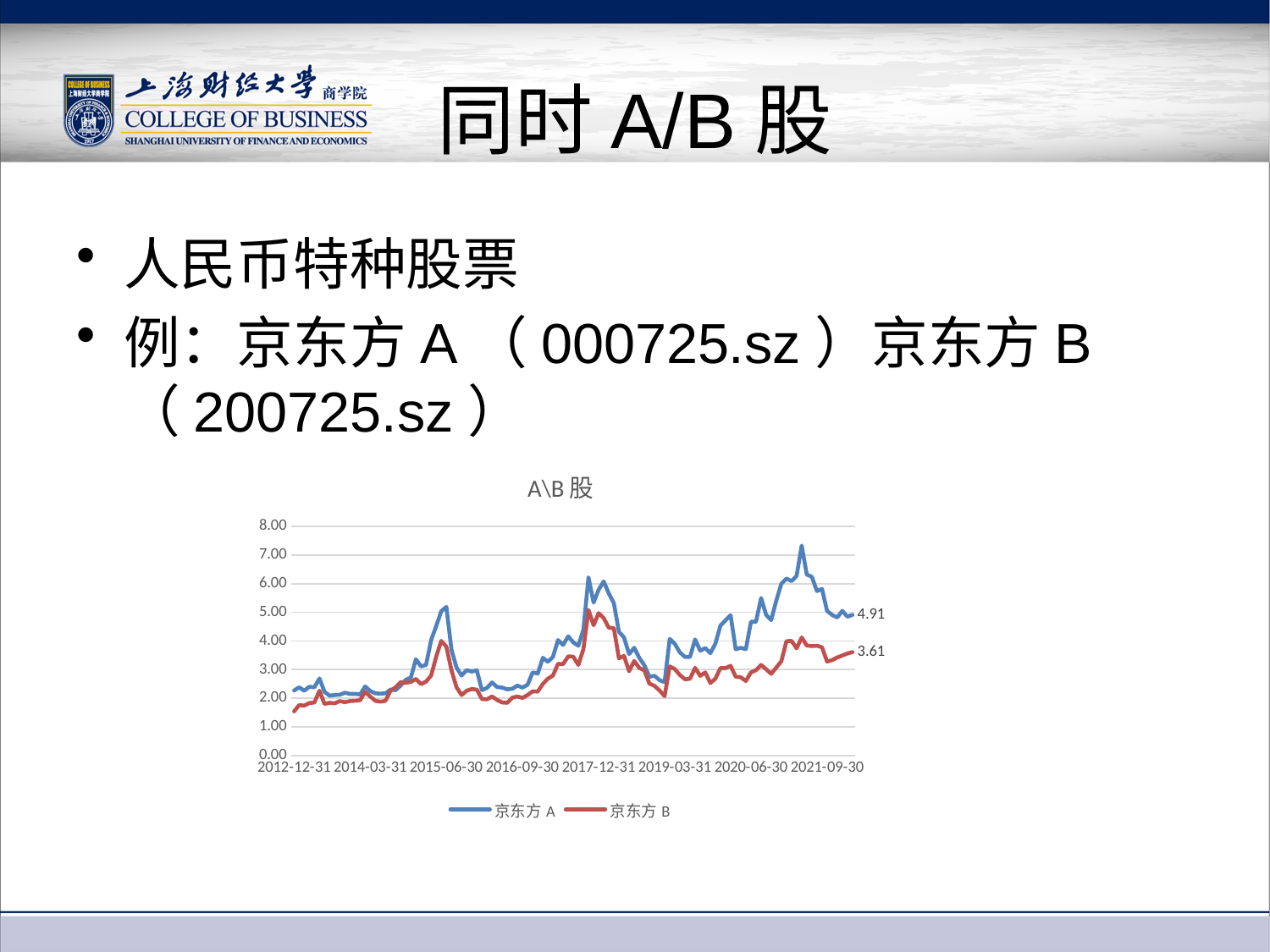
What is the last labelled value for 京东方 A in the chart? 4.91 Is the highest point of the 京东方 A line greater or less than 7.00? greater Which series stays above the other for most of the period shown, 京东方 A or 京东方 B? 京东方 A What are the two series named in the chart legend? 京东方 A and 京东方 B What is the last labelled value for 京东方 B in the chart? 3.61 What is the title of the chart? A\B 股 What kind of chart is shown on the slide? line chart What is the difference between the final labelled values of 京东方 A (4.91) and 京东方 B (3.61)? 1.30 Is the highest point of the 京东方 B line greater or less than 6.00? less Is the value of 京东方 A at the start of the chart (2012-12-31) greater or less than 3.00? less At the end of the series, which is higher, 京东方 A or 京东方 B? 京东方 A How many series does the legend of the chart list? 2